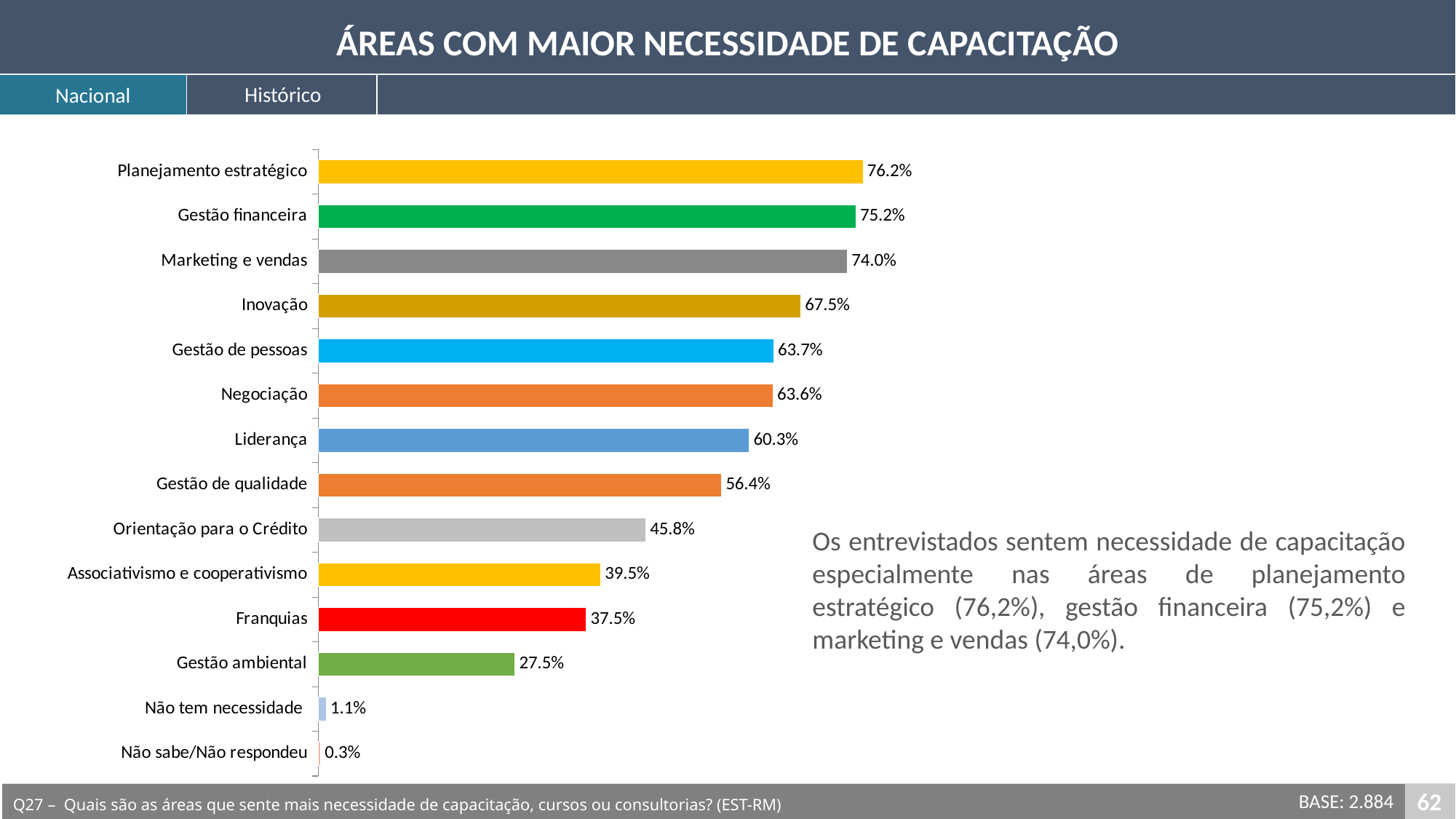
What is the difference between the values for Planejamento estratégico and Gestão financeira? 1.0 percentage points How many categories are shown in the chart? 14 What is the value for Franquias? 37.5% Which category has the highest value? Planejamento estratégico What kind of chart is shown on the slide? Bar chart What is the title of the slide containing the chart? ÁREAS COM MAIOR NECESSIDADE DE CAPACITAÇÃO What is the value for Não tem necessidade? 1.1% What is the difference between the values for Inovação and Gestão ambiental? 40.0 percentage points Which is larger, the value for Inovação or the value for Liderança? Inovação What is the value for Planejamento estratégico? 76.2% Which category has the lowest value? Não sabe/Não respondeu What is the value for Gestão de qualidade? 56.4%